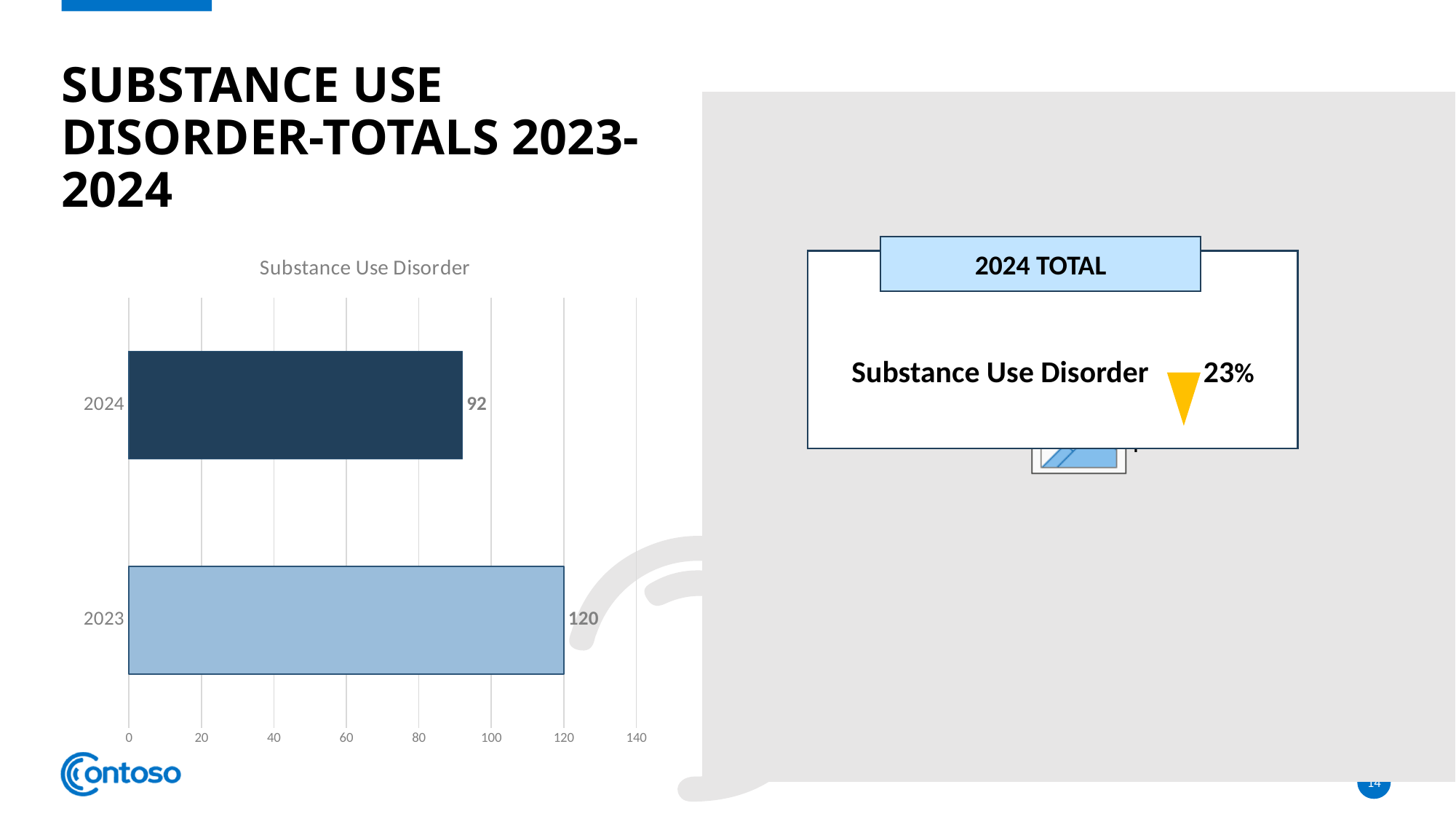
Which year has the lower value in the Substance Use Disorder chart? 2024 What is the difference between the 2023 and 2024 values in the Substance Use Disorder chart? 28 Which year has the higher value in the Substance Use Disorder chart? 2023 What is the highest value shown on the x axis of the Substance Use Disorder chart? 140 Did the Substance Use Disorder total rise or fall from 2023 to 2024? fall What is the value for 2023 in the Substance Use Disorder chart? 120 What is the value for 2024 in the Substance Use Disorder chart? 92 How many bars are shown in the Substance Use Disorder chart? 2 Is the value for 2024 greater or less than 100 in the Substance Use Disorder chart? less What kind of chart is the Substance Use Disorder chart? bar chart What is the title of the chart on the slide? Substance Use Disorder Is the value for 2024 larger or smaller than the value for 2023 in the Substance Use Disorder chart? smaller